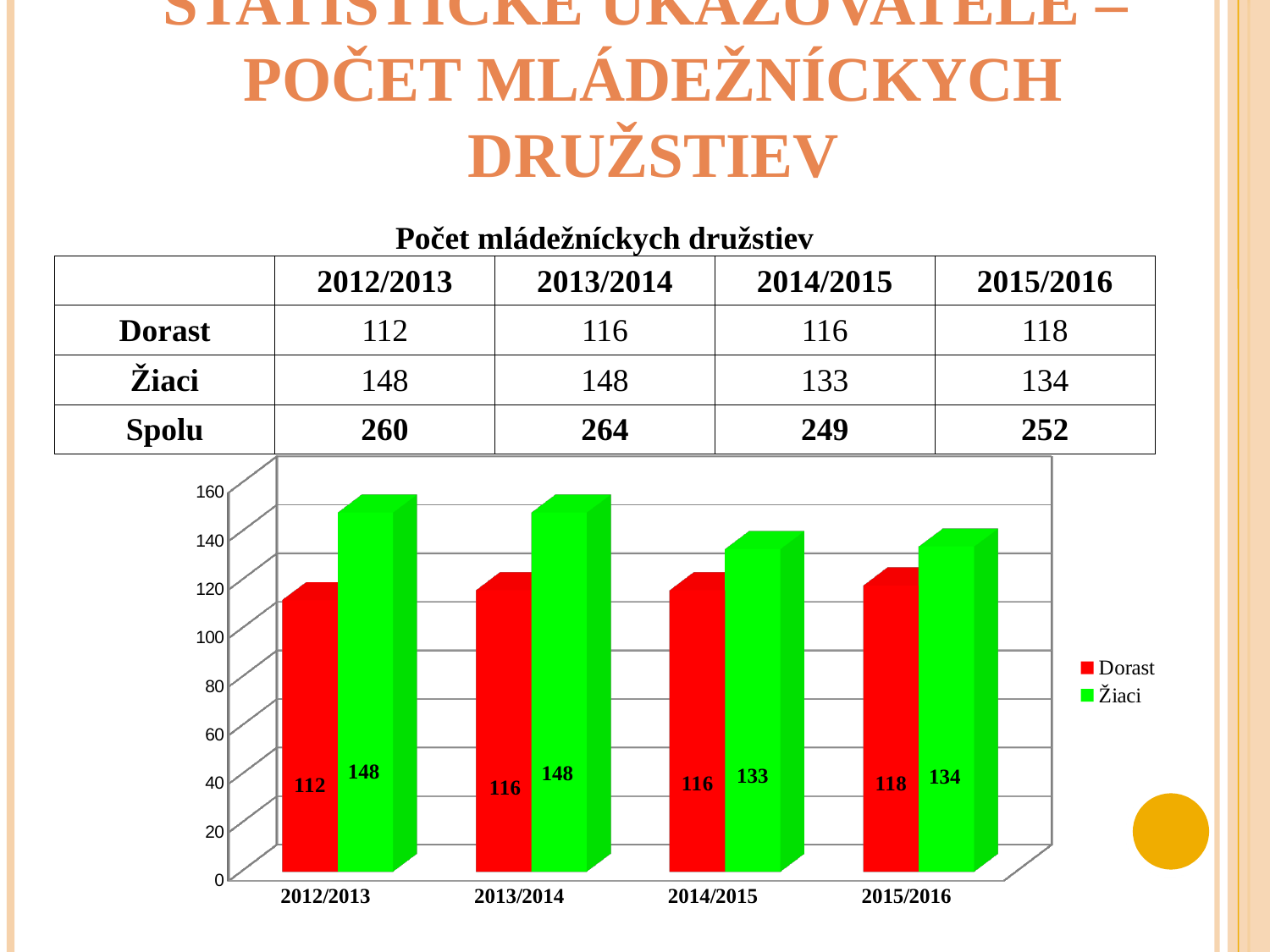
How many series does the chart legend list? 2 How many seasons are shown on the x axis of the chart? 4 In which season is the Žiaci value lowest? 2014/2015 Which is larger in 2015/2016, Dorast or Žiaci? Žiaci What is the value for Žiaci in 2015/2016? 134 What is the value for Dorast in 2012/2013? 112 In which season is the Dorast value highest? 2015/2016 What is the value for Žiaci in 2014/2015? 133 Which colour represents Dorast in the chart? red What kind of chart is shown on the slide? bar chart What is the difference between the Žiaci values in 2013/2014 and 2014/2015? 15 What is the difference between the Žiaci and Dorast values in 2012/2013? 36